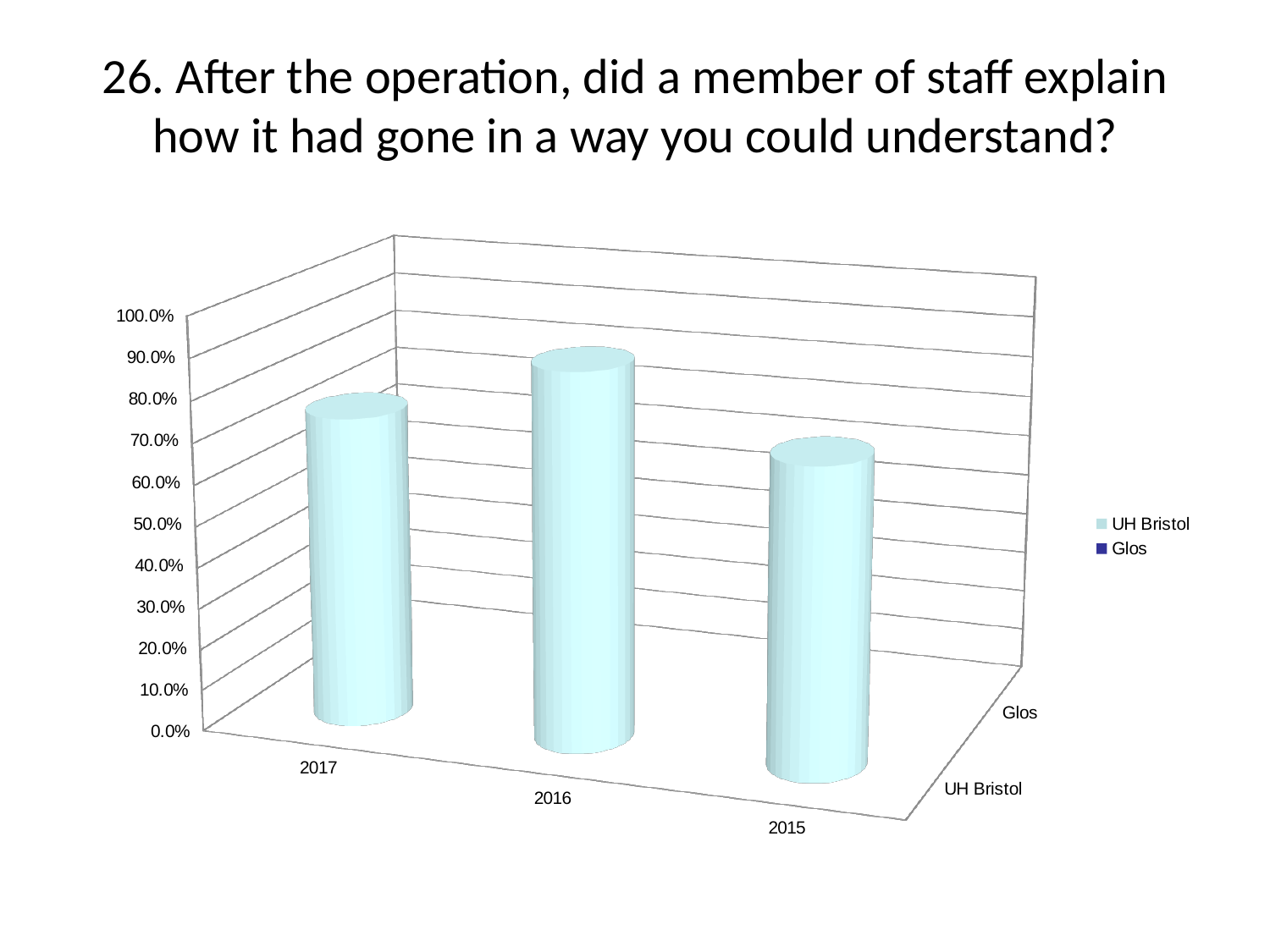
Which year has the highest UH Bristol bar? 2016 Is the UH Bristol value for 2017 greater or less than 50.0%? greater What kind of chart is shown on the slide? bar chart Is the UH Bristol value for 2015 greater or less than 50.0%? greater Is the UH Bristol value for 2017 greater or less than 90.0%? less How many series does the chart's legend list? 2 Which is larger, the UH Bristol value for 2016 or for 2015? 2016 What are the two series names listed in the chart's legend? UH Bristol and Glos How many year categories are shown on the x axis of the chart? 3 What is the maximum value shown on the chart's vertical axis? 100.0%